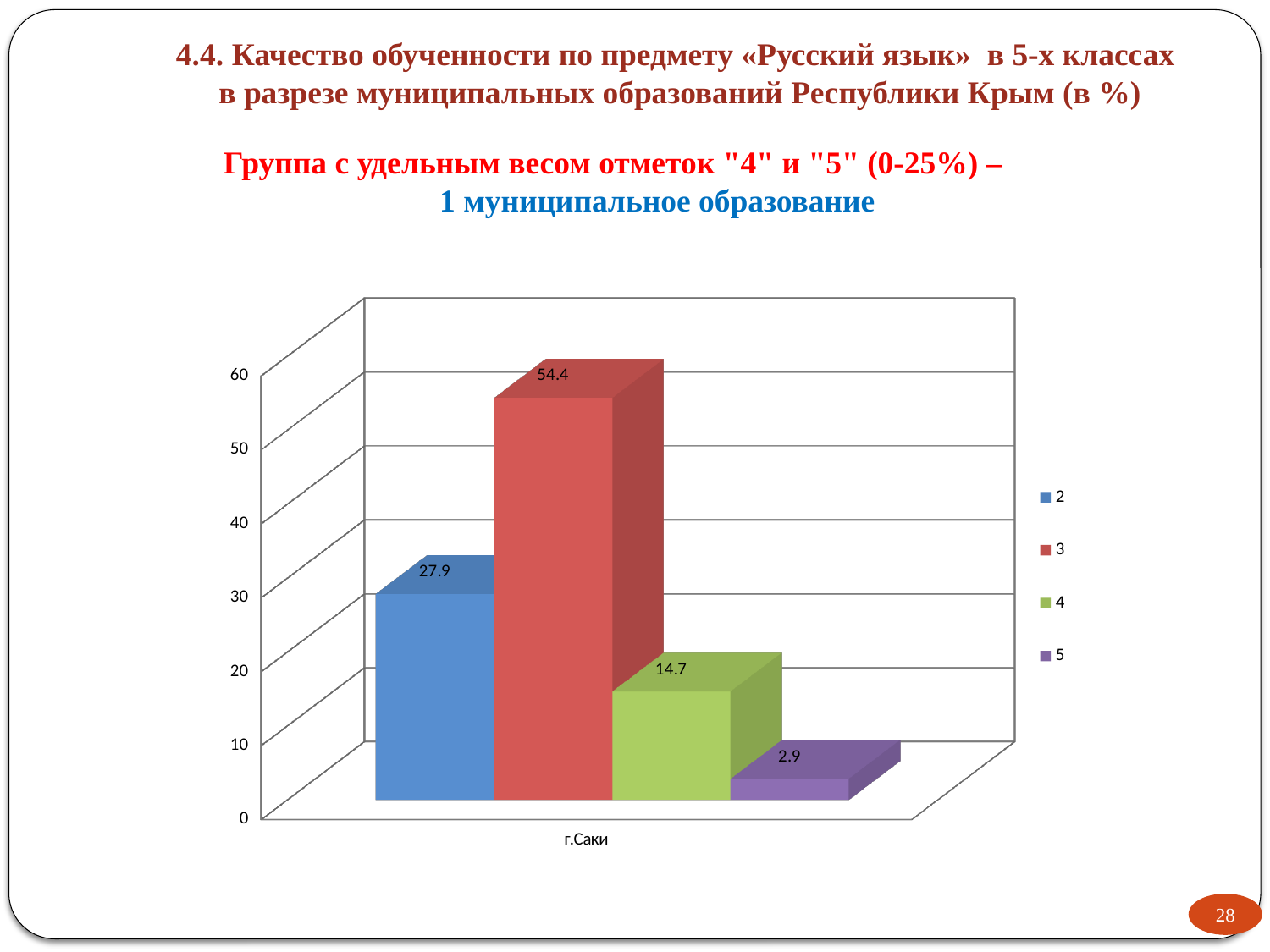
What kind of chart is shown on the slide? bar chart What is the value for series "4" for г.Саки? 14.7 What is the value for series "3" for г.Саки? 54.4 Which series has the lowest value for г.Саки? 5 What is the category label shown on the x axis? г.Саки Which series has the highest value for г.Саки? 3 What is the difference between the values for series "3" and series "2"? 26.5 What is the value for series "5" for г.Саки? 2.9 What is the value for series "2" for г.Саки? 27.9 How many series does the legend list? 4 Is the value for series "3" greater or less than 50? greater Which is larger for г.Саки: the value for series "2" or series "4"? 2